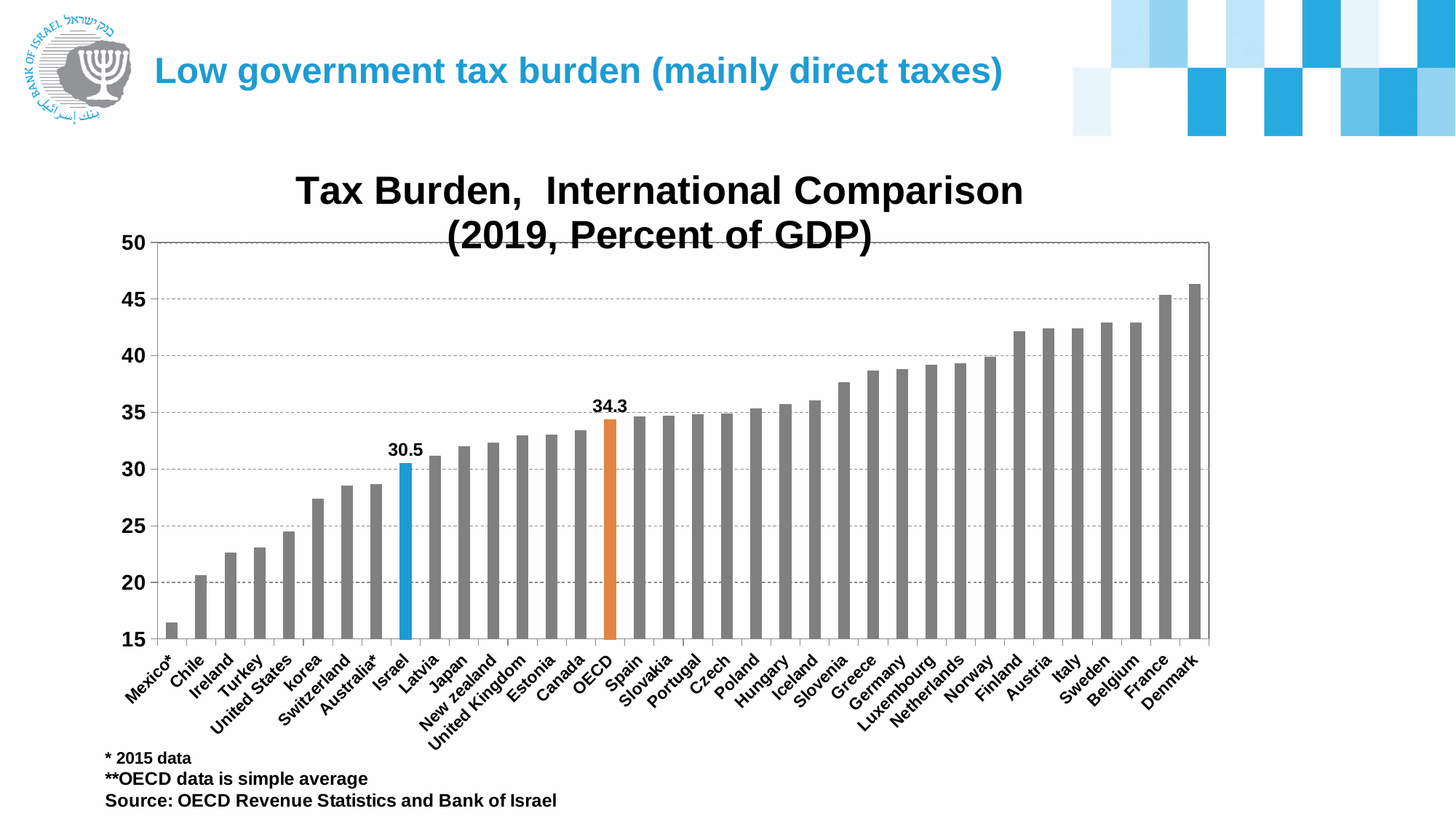
Is the value for Denmark greater or less than 45? greater Is the value for Finland greater or less than 40? greater What is the value for OECD in the Tax Burden chart? 34.3 What is the value for Israel in the Tax Burden chart? 30.5 How many countries/categories are shown on the x axis of the chart? 36 Which is larger, the value for Israel or the value for OECD? OECD Is the value for Mexico* greater or less than 20? less Which country has the lowest tax burden in the chart? Mexico* Do the values rise or fall moving from left to right along the x axis? rise What kind of chart is shown on the slide? bar chart What is the difference between the OECD value and the Israel value? 3.8 Which country has the highest tax burden in the chart? Denmark